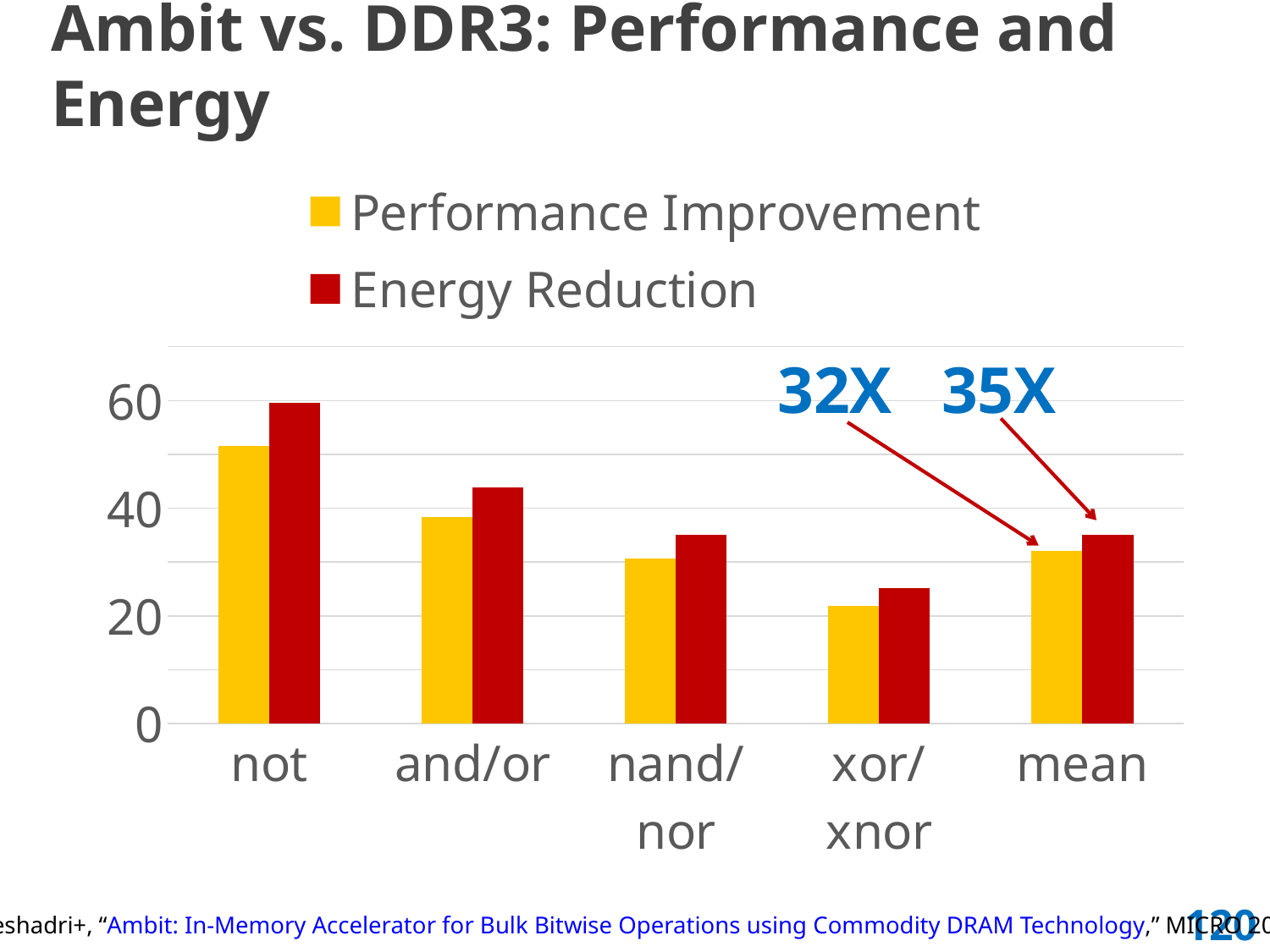
What is the difference between the Energy Reduction and Performance Improvement values for the mean category? 3X For the not category, which is larger: Performance Improvement or Energy Reduction? Energy Reduction Is the Energy Reduction value for xor/xnor greater or less than 40? less Is the Performance Improvement value for not greater or less than 40? greater Which category has the highest Performance Improvement? not Do the Energy Reduction values rise or fall from not to xor/xnor along the x axis? fall What is the Energy Reduction value for the mean category? 35X How many series does the legend list? 2 What kind of chart is shown on the slide? bar chart What is the Performance Improvement value for the mean category? 32X Which category has the lowest Energy Reduction? xor/xnor How many categories are shown on the x axis? 5